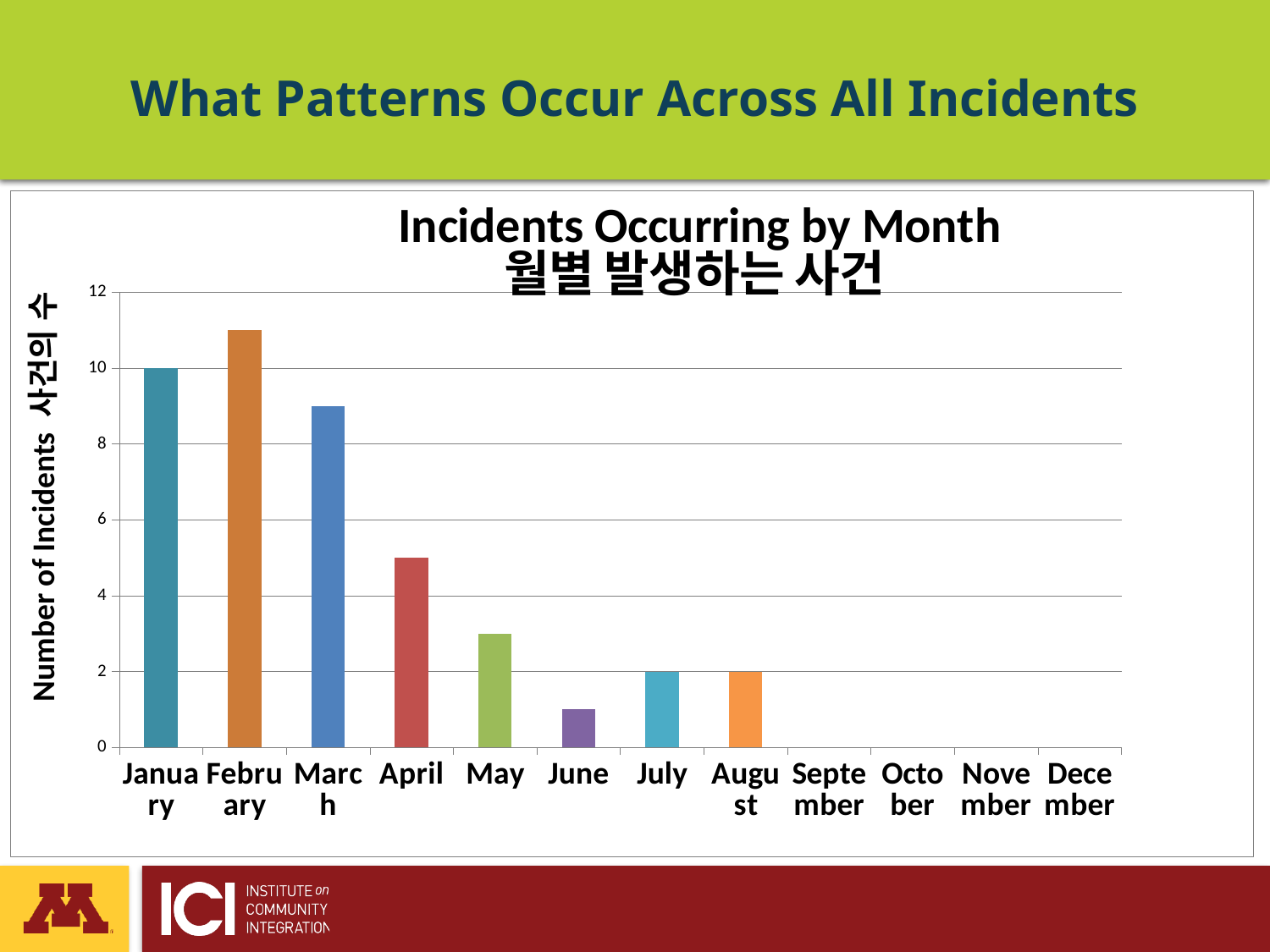
Which month has the highest number of incidents? February What is the number of incidents for August? 2 What is the number of incidents for January? 10 Is the value for June greater or less than 2? less How many months are listed along the x axis of the chart? 12 What is the difference between the number of incidents in January and in July? 8 Which has more incidents, January or March? January What type of chart is shown on the slide? bar chart What is the title of the chart? Incidents Occurring by Month 월별 발생하는 사건 Is the value for February greater or less than 10? greater Is the value for April greater or less than 4? greater What is the number of incidents for July? 2